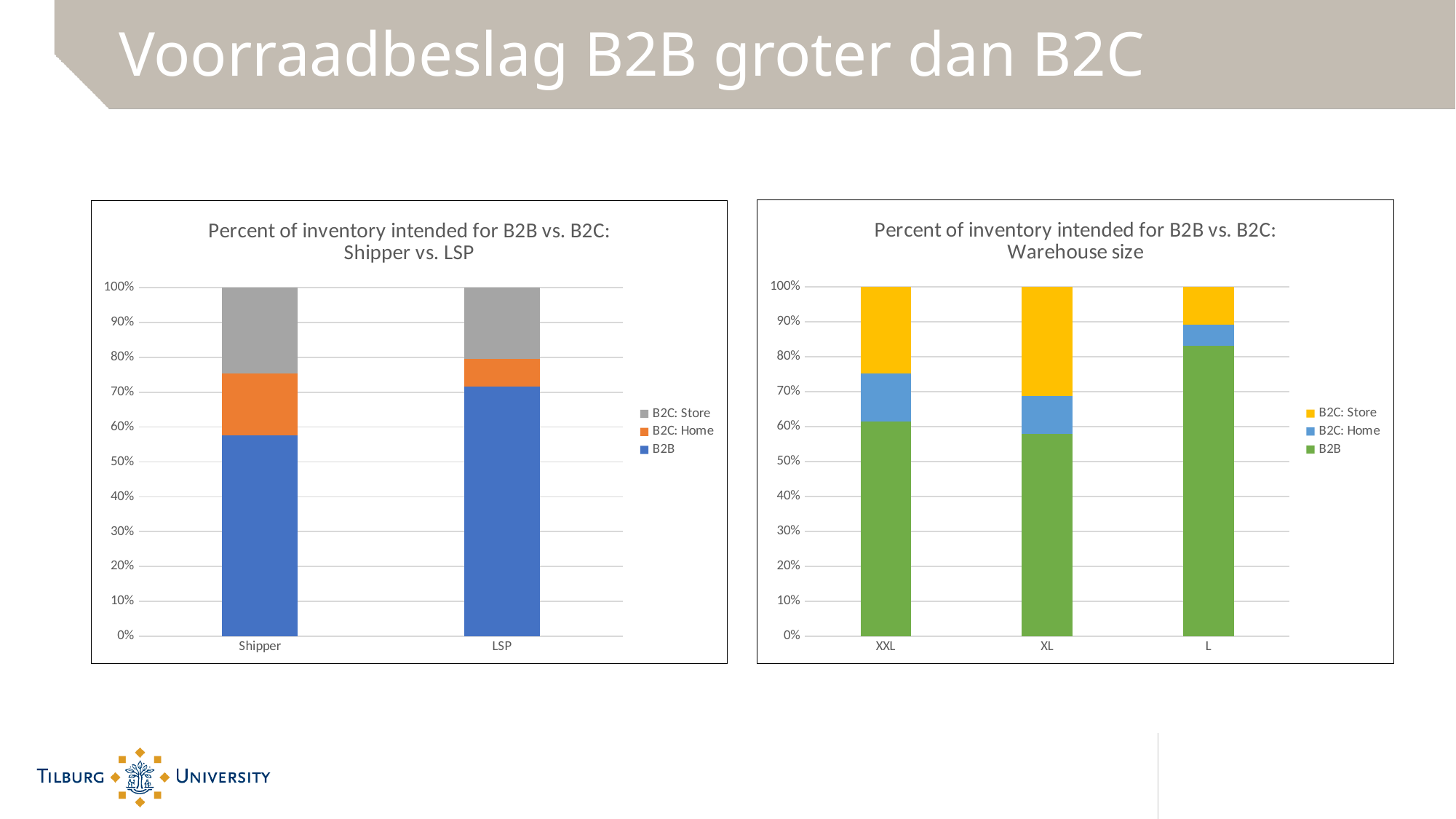
What kind of chart is the 'Warehouse size' chart? stacked bar chart In the 'Warehouse size' chart, which warehouse size has the highest B2B share? L In the 'Warehouse size' chart, is the B2B value for L greater or less than 80%? greater In the 'Shipper vs. LSP' chart, which category has the larger B2C: Home segment, Shipper or LSP? Shipper In the 'Warehouse size' chart, which warehouse size has the largest B2C: Store segment, XL or L? XL How many warehouse sizes are shown on the x axis of the 'Warehouse size' chart? 3 How many categories are shown on the x axis of the 'Shipper vs. LSP' chart? 2 In the 'Warehouse size' chart, is the B2B value for XL greater or less than 50%? greater In the 'Shipper vs. LSP' chart, is the B2B value for Shipper greater or less than 50%? greater How many series does the legend of the 'Shipper vs. LSP' chart list? 3 In the 'Shipper vs. LSP' chart, which category has the larger B2B share, Shipper or LSP? LSP